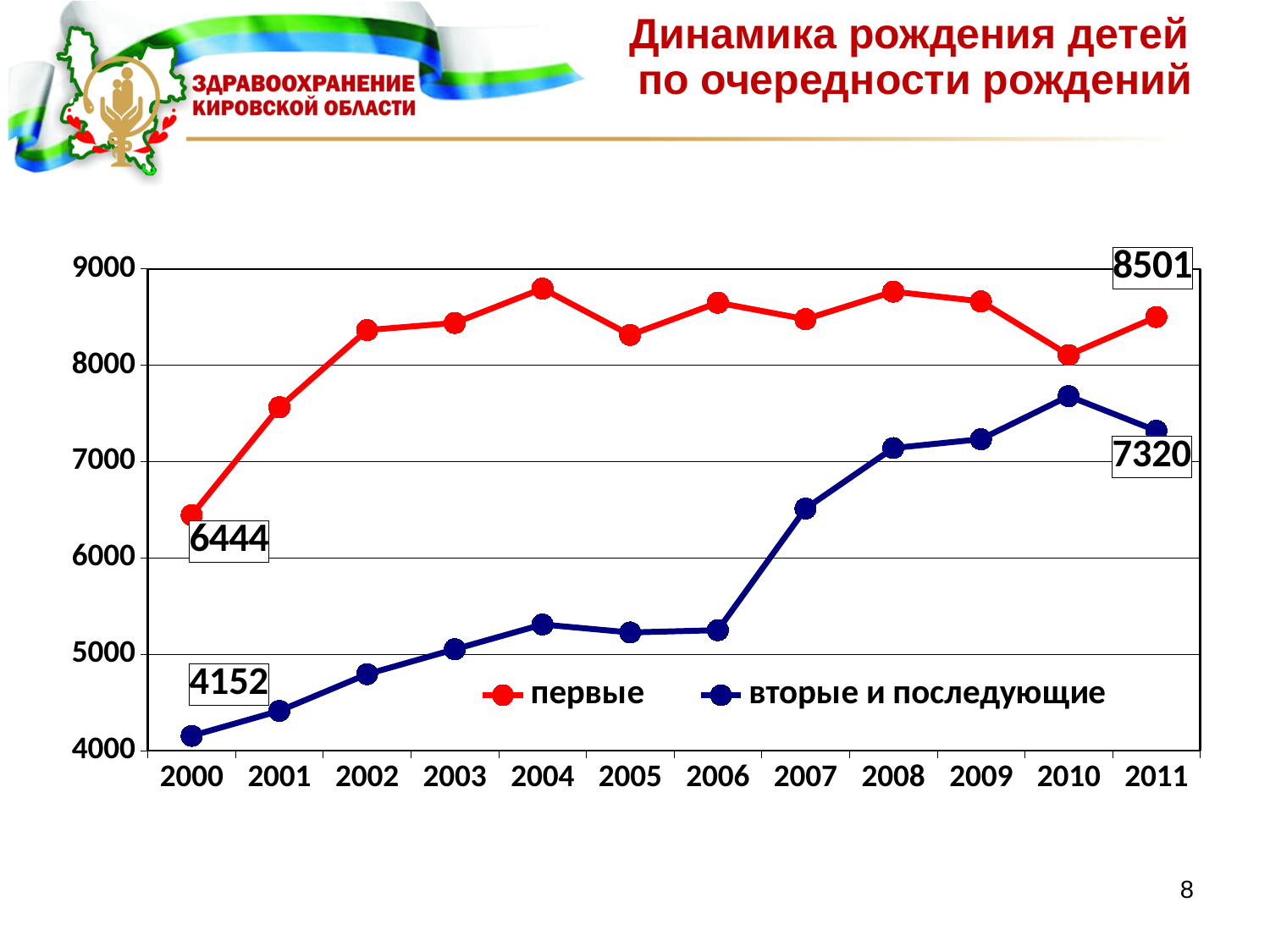
What is the difference between the "первые" and "вторые и последующие" values in 2011? 1181 In which year is the "вторые и последующие" series at its highest? 2010 What is the value of the "первые" series in 2011? 8501 What is the value of the "вторые и последующие" series in 2011? 7320 What is the value of the "вторые и последующие" series in 2000? 4152 By how much did the "вторые и последующие" series increase from 2000 to 2011? 3168 What kind of chart is shown on the slide? line chart By how much did the "первые" series increase from 2000 to 2011? 2057 How many series does the legend list? 2 Is the value of the "вторые и последующие" series in 2006 greater or less than 6000? less What is the value of the "первые" series in 2000? 6444 How many years are plotted on the x axis? 12